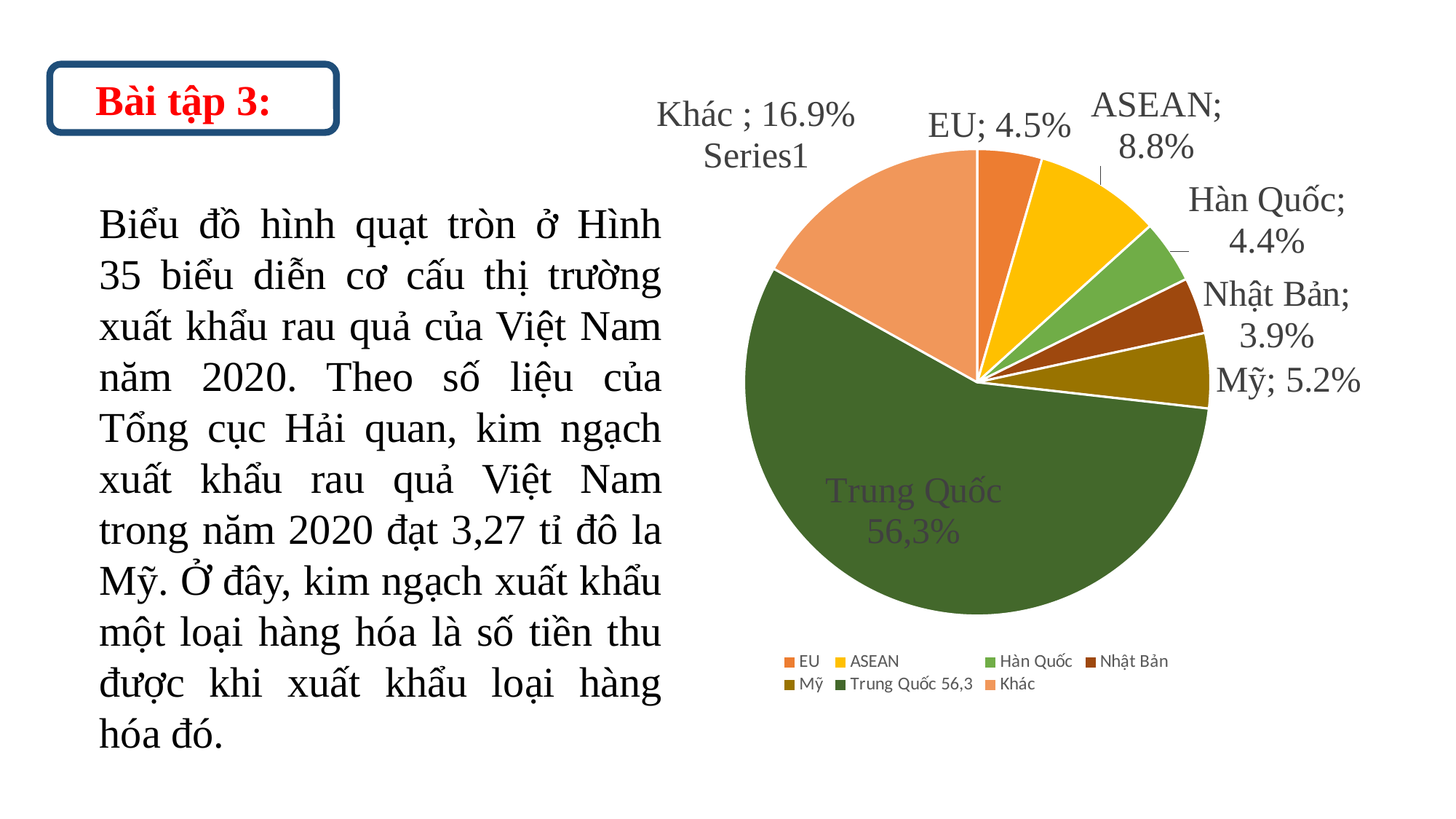
Which is larger, the share of ASEAN or the share of Mỹ? ASEAN What kind of chart is shown on the slide? Pie chart What is the value shown for Khác? 16.9% What is the difference between the shares of Khác and ASEAN? 8.1 percentage points Which category has the smallest slice of the pie? Nhật Bản Which category has the largest slice of the pie? Trung Quốc What is the value shown for Nhật Bản? 3.9% What share of the pie does Trung Quốc hold? 56,3% What is the value shown for ASEAN? 8.8% How many slices does the pie chart have? 7 What colour is the slice for Trung Quốc? Dark green What is the value shown for Mỹ? 5.2%